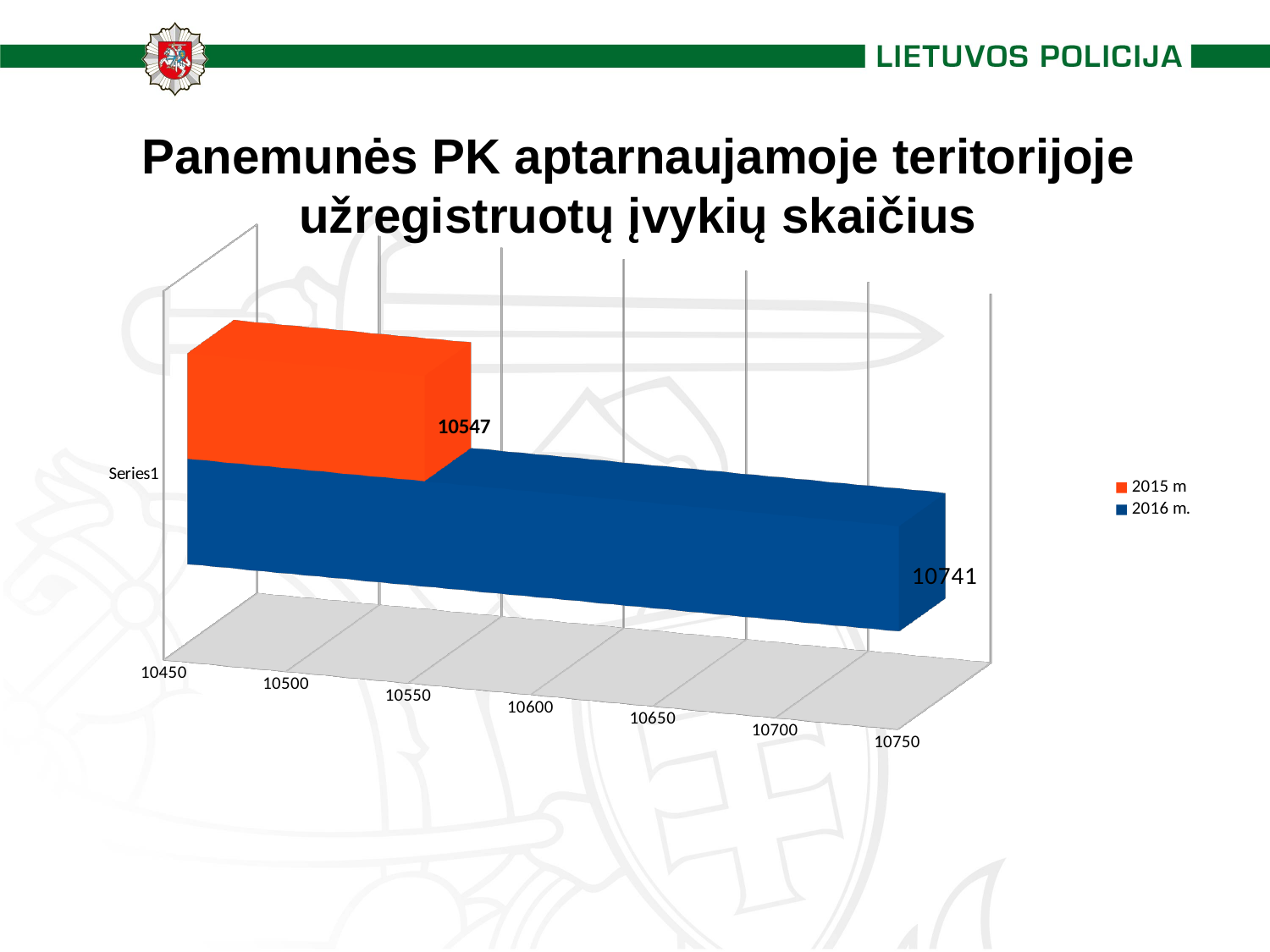
What colour is the bar for 2016 m.? blue What is the category label shown on the vertical axis? Series1 Is the value for 2015 m greater or less than 10600? less Which series has the lowest value? 2015 m What kind of chart is shown on the slide? bar chart Which series has the higher value, 2015 m or 2016 m.? 2016 m. What is the title of the chart? Panemunės PK aptarnaujamoje teritorijoje užregistruotų įvykių skaičius Is the value for 2016 m. greater or less than 10700? greater What is the value for 2015 m? 10547 What is the value for 2016 m.? 10741 How many series does the legend list? 2 What is the difference between the 2016 m. value and the 2015 m value? 194